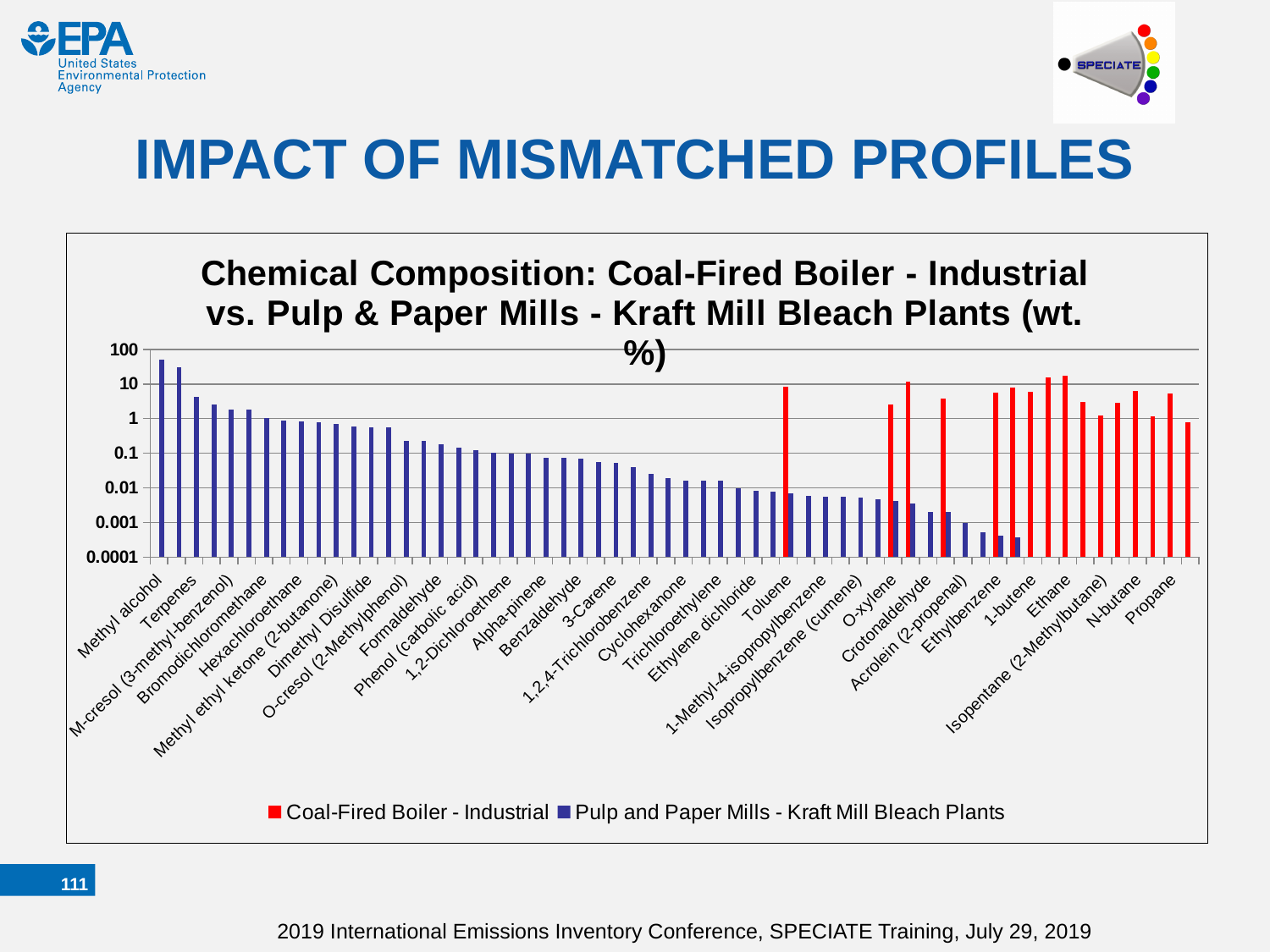
Is the Pulp and Paper Mills - Kraft Mill Bleach Plants value for Formaldehyde greater or less than 1? less Is the Coal-Fired Boiler - Industrial value for Propane greater or less than 1? greater How many series does the legend list? 2 Which series is shown in blue in the legend? Pulp and Paper Mills - Kraft Mill Bleach Plants What kind of chart is shown on the slide? Bar chart Is the Pulp and Paper Mills - Kraft Mill Bleach Plants value for Terpenes greater or less than 10? less Which series is shown in red in the legend? Coal-Fired Boiler - Industrial Which chemical has the highest value for the Pulp and Paper Mills - Kraft Mill Bleach Plants series? Methyl alcohol For Toluene, which series has the larger value: Coal-Fired Boiler - Industrial or Pulp and Paper Mills - Kraft Mill Bleach Plants? Coal-Fired Boiler - Industrial Do the Pulp and Paper Mills - Kraft Mill Bleach Plants values generally rise or fall from left to right along the x axis? fall